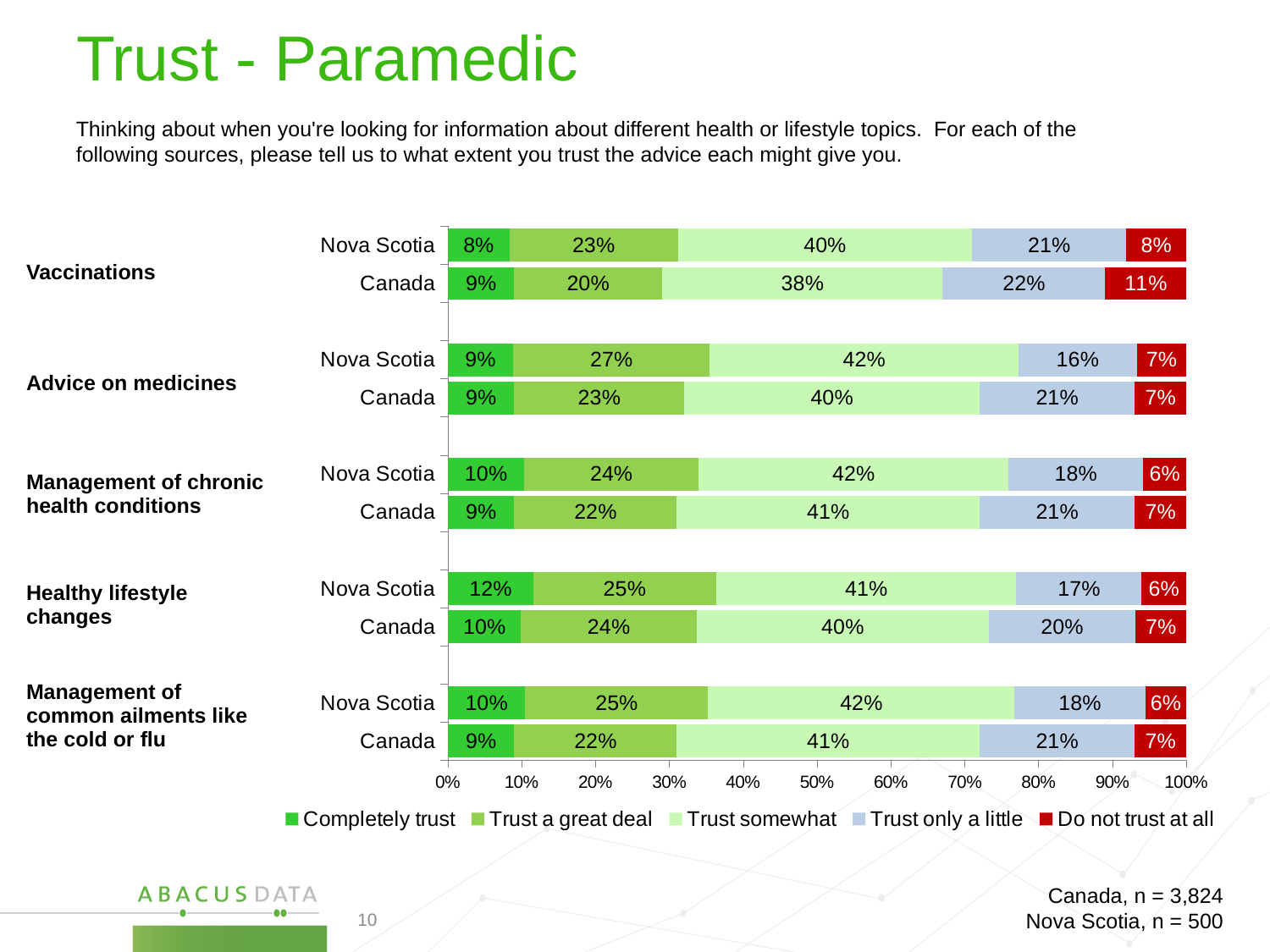
Which bar has the highest 'Completely trust' value? Nova Scotia, Healthy lifestyle changes (12%) How many bars are plotted in the chart? 10 What colour represents 'Do not trust at all' in the legend? Red For vaccinations, what share of Canada respondents do not trust a paramedic at all? 11% What kind of chart is shown on the slide? Stacked bar chart What percentage of Nova Scotia respondents say they completely trust a paramedic's advice on vaccinations? 8% For advice on medicines, what is the difference between Nova Scotia's and Canada's 'Trust a great deal' values? 4 percentage points For healthy lifestyle changes, which has the larger 'Trust only a little' value, Nova Scotia or Canada? Canada Which bar has the highest 'Do not trust at all' value? Canada, Vaccinations (11%) How many series does the legend list? 5 What is the 'Trust a great deal' value for Nova Scotia on advice on medicines? 27% For vaccinations, how many percentage points higher is Canada's 'Do not trust at all' value than Nova Scotia's? 3 percentage points